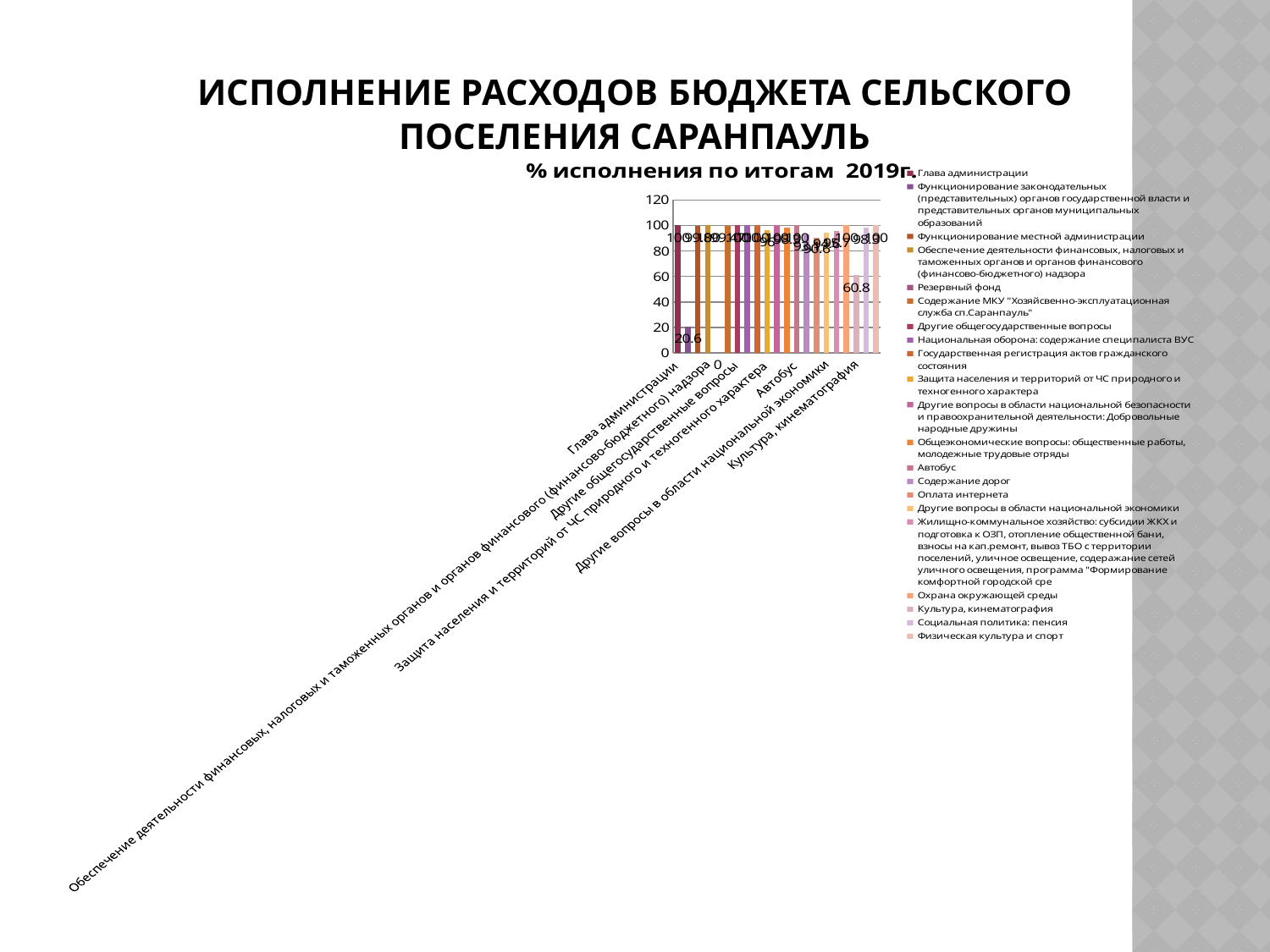
What kind of chart is shown on the slide? bar chart What is the highest value shown on the chart's vertical axis? 120 How many series does the chart legend list? 21 What is the difference between the bar labelled 60.8 and the bar labelled 20.6? 40.2 What is the title of the chart? % исполнения по итогам 2019г. What is the second-lowest value labelled on the chart? 20.6 Is the lowest bar on the chart greater or less than 40? less Which is larger: the value for Глава администрации or the value for Функционирование законодательных (представительных) органов государственной власти и представительных органов муниципальных образований? Глава администрации What is the value of the lowest bar on the chart? 0 Is the bar labelled 60.8 greater or less than 80? less Is the value for Глава администрации greater or less than 80? greater Which series has the lowest value on the chart? Резервный фонд